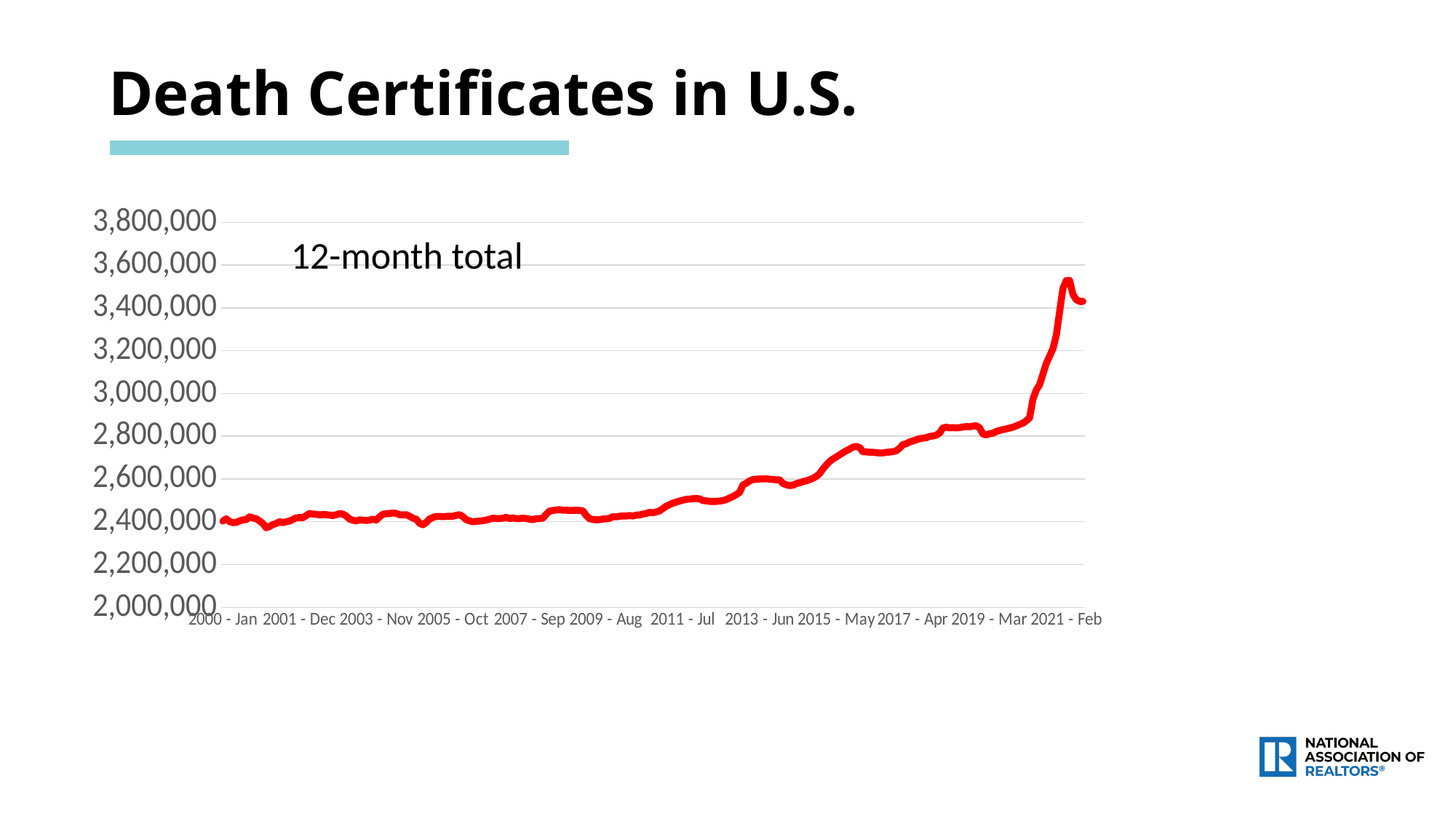
Is the value at 2013 - Jun greater or less than 2,400,000? greater What is the title of the chart on the slide? Death Certificates in U.S. What kind of chart is shown on the slide? line chart How many date labels are shown along the x axis? 12 Is the value at 2021 - Feb greater or less than 3,000,000? greater Is the value at 2009 - Aug greater or less than 2,600,000? less Which is larger, the value at 2017 - Apr or the value at 2005 - Oct? 2017 - Apr Overall, do the values rise or fall from 2000 - Jan to 2021 - Feb? rise What label describes the measure plotted by the line? 12-month total